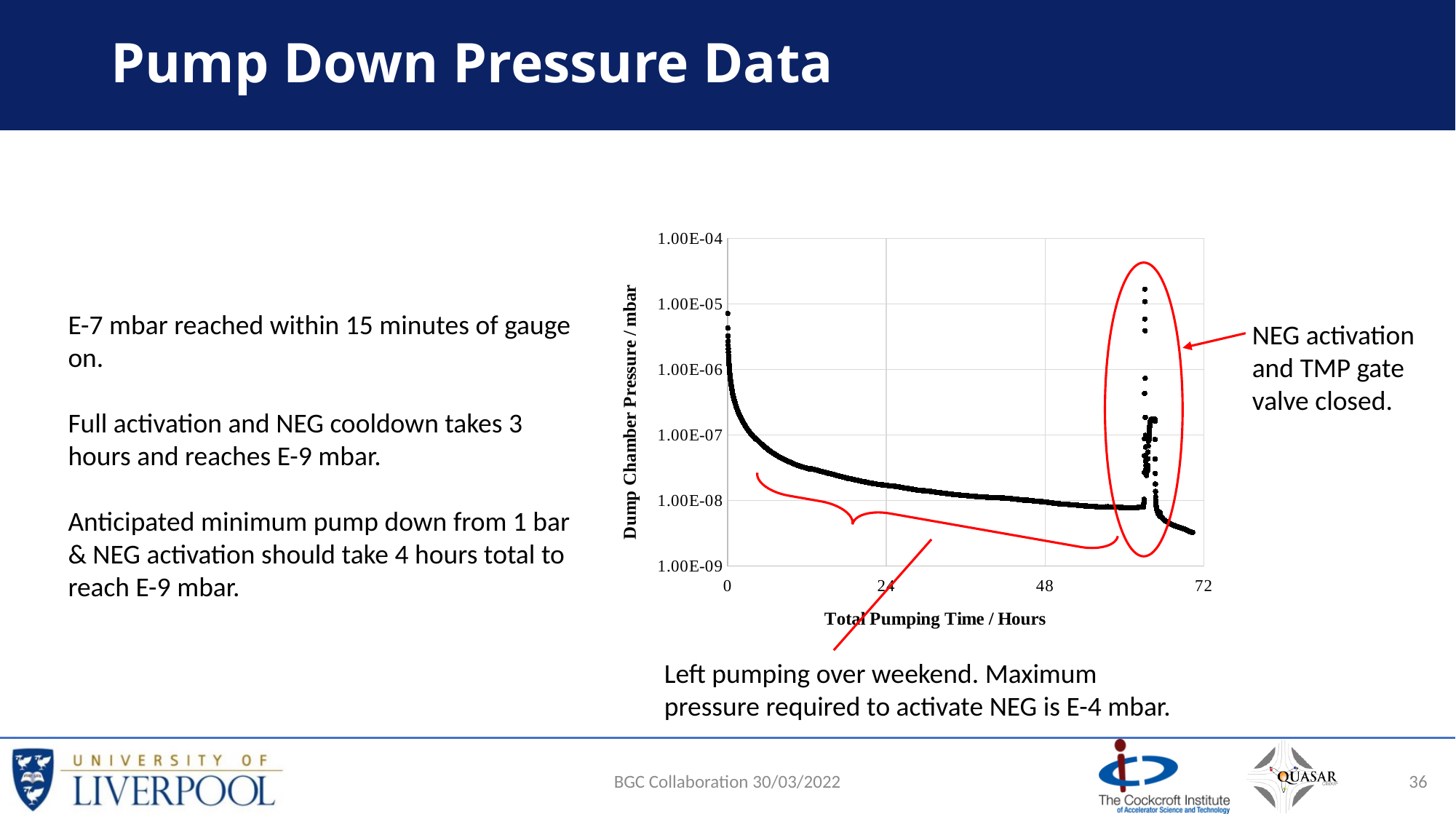
How many tick labels are shown on the horizontal axis of the chart? 4 Is the pressure at 60 hours of pumping time greater or less than 1.00E-07 mbar? less Is the highest pressure reached during the NEG activation spike greater or less than 1.00E-05 mbar? greater What is the label of the vertical axis of the chart? Dump Chamber Pressure / mbar Is the pressure at the end of the data (around 70 hours) greater or less than 1.00E-08 mbar? less What is the label of the horizontal axis of the chart? Total Pumping Time / Hours What kind of chart is shown on the slide? scatter chart Does the pressure rise or fall along the x axis between 0 and 48 hours? fall